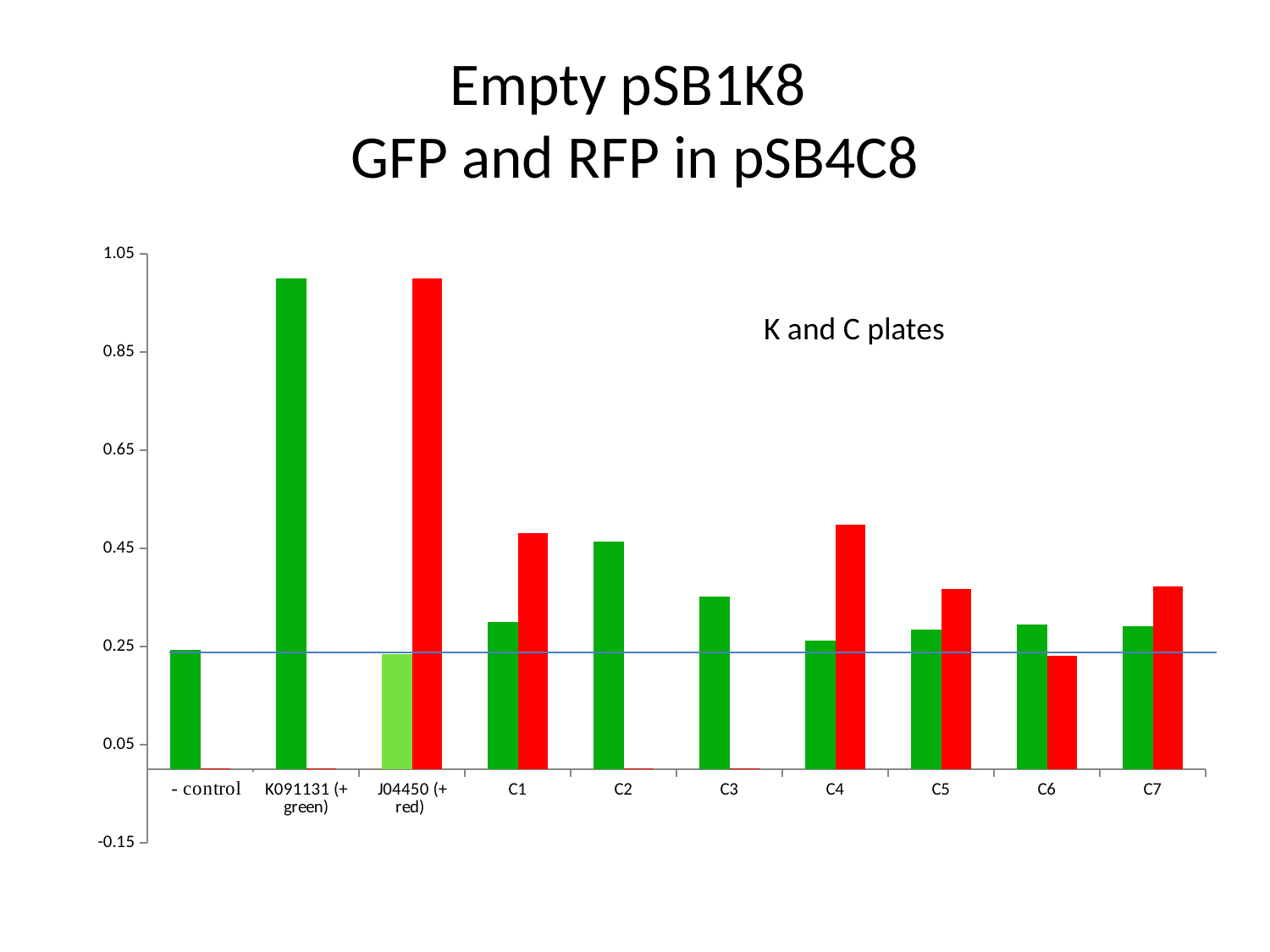
Which category has the tallest red bar? J04450 (+ red) Is the red bar for C5 greater or less than 0.45? less What kind of chart is shown on the slide? bar chart How many categories are shown along the x axis of the chart? 10 Is the red bar for J04450 (+ red) greater or less than 0.85? greater What is the title of the slide? Empty pSB1K8 GFP and RFP in pSB4C8 For C6, which bar is taller, the green bar or the red bar? green bar Which category has the tallest green bar? K091131 (+ green) Is the green bar for C3 greater or less than 0.45? less For C4, which bar is taller, the green bar or the red bar? red bar